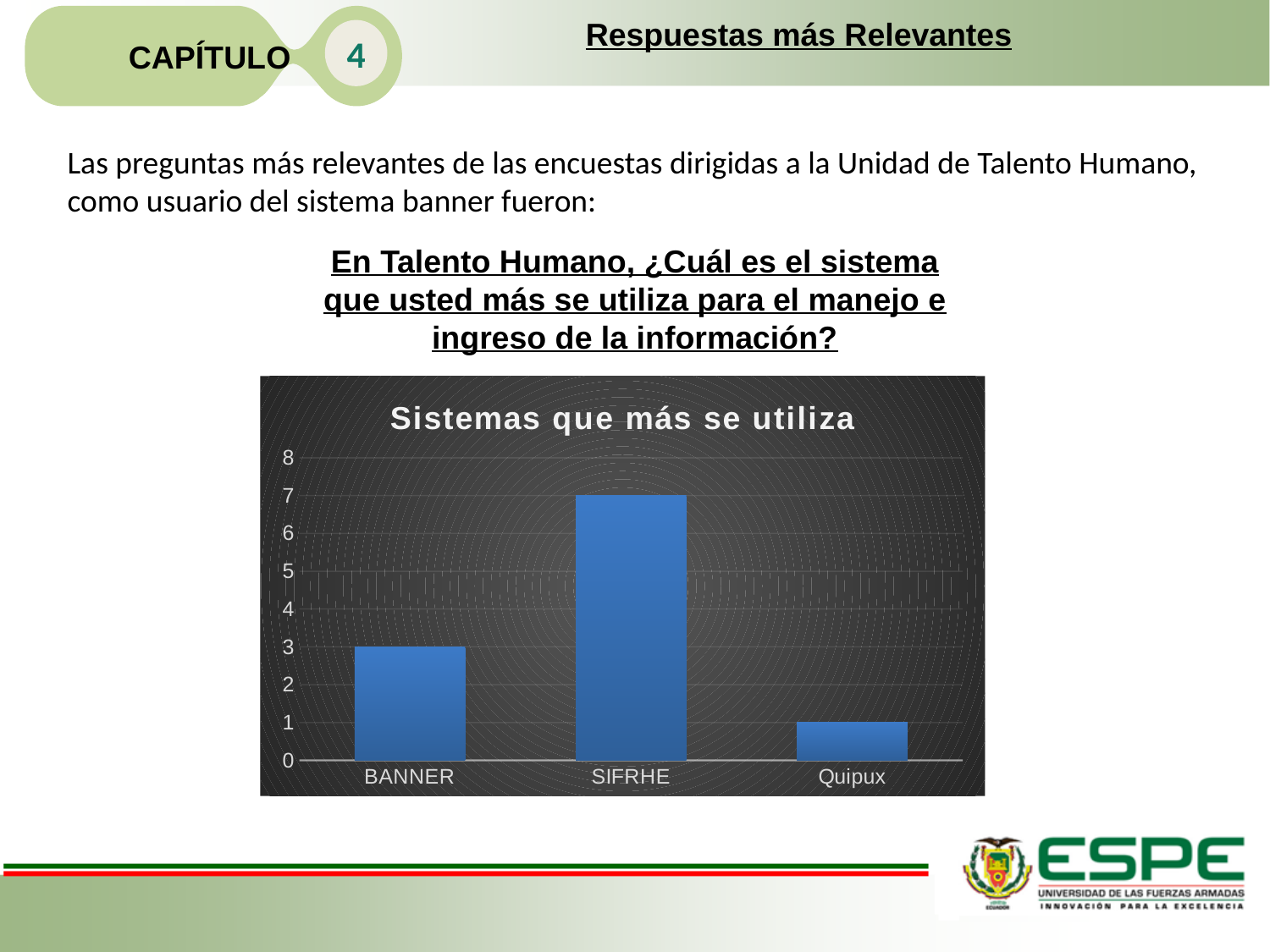
Is the value for SIFRHE greater or less than 5? greater What is the value for Quipux? 1 What is the value for BANNER? 3 How many categories are shown on the x axis? 3 What is the title of the chart? Sistemas que más se utiliza Which system has the lowest value? Quipux What is the difference between the values for SIFRHE and BANNER? 4 What kind of chart is shown? bar chart What is the value for SIFRHE? 7 Which system has the highest value? SIFRHE What is the difference between the values for BANNER and Quipux? 2 Which is larger, the value for BANNER or the value for Quipux? BANNER